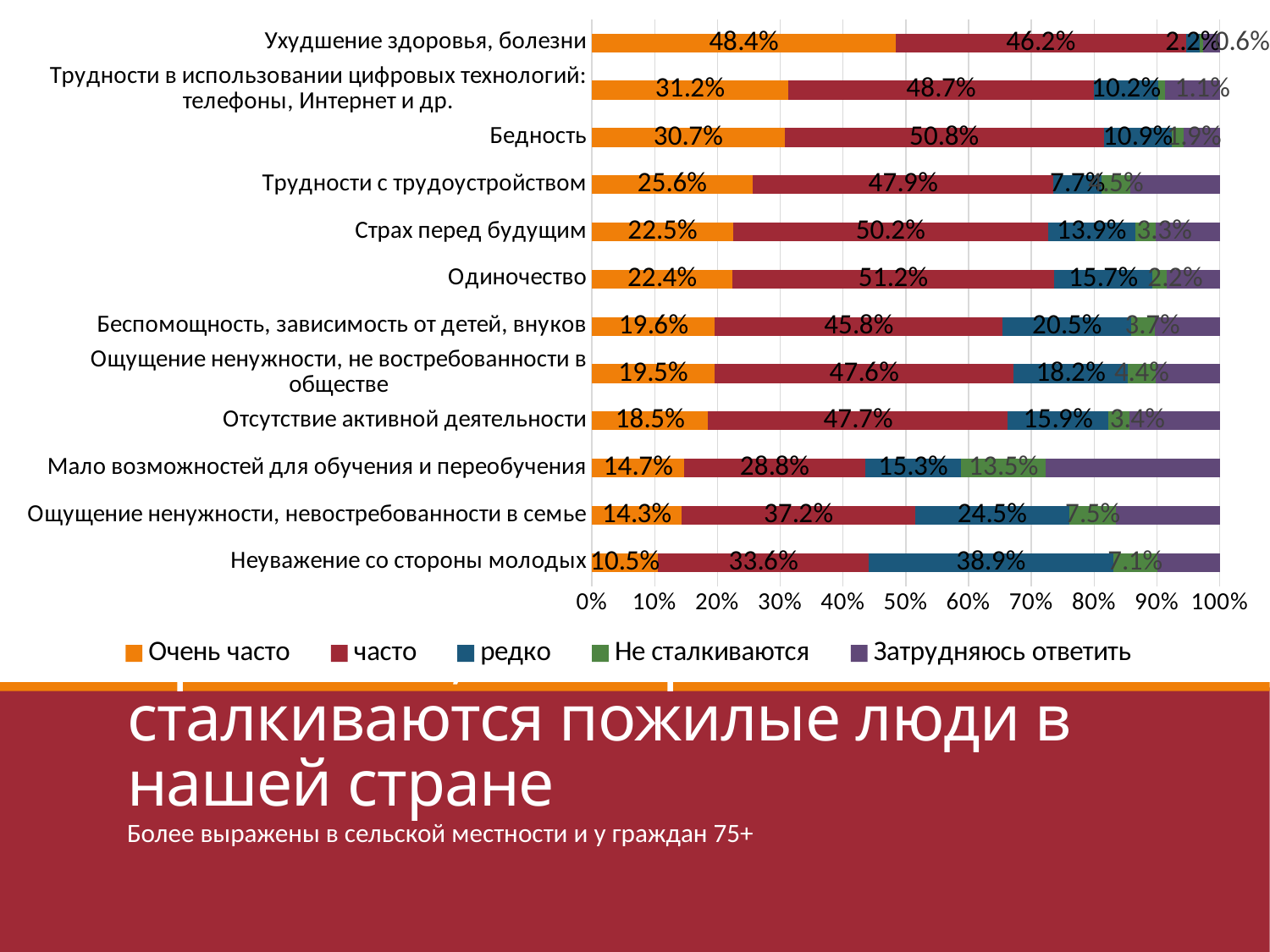
What is the difference between the 'Очень часто' values for 'Бедность' and 'Страх перед будущим'? 8.2% What is the 'редко' value for 'Неуважение со стороны молодых'? 38.9% How many categories are shown on the chart? 12 Which is larger: the 'часто' value for 'Бедность' or for 'Трудности с трудоустройством'? Бедность What is the 'часто' value for 'Одиночество'? 51.2% Which category has the highest 'Очень часто' value? Ухудшение здоровья, болезни What kind of chart is shown on the slide? Stacked bar chart What is the 'Не сталкиваются' value for 'Мало возможностей для обучения и переобучения'? 13.5% Which series is shown in orange in the legend? Очень часто Which category has the lowest 'Очень часто' value? Неуважение со стороны молодых What is the 'Очень часто' value for 'Ухудшение здоровья, болезни'? 48.4% How many series does the legend list? 5